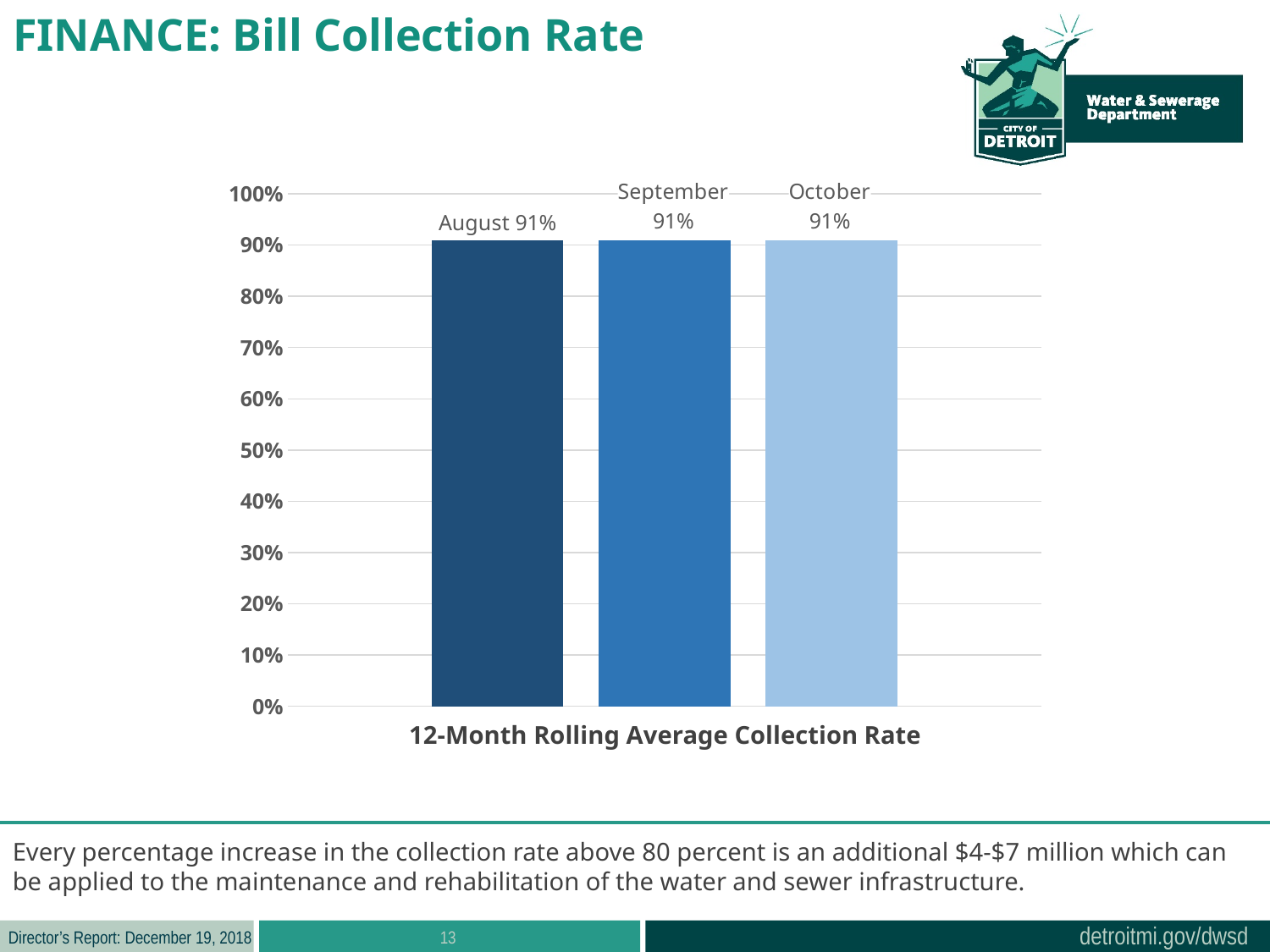
What is the difference between the October and August collection rates? 0% Is the value for October greater or less than 100%? less What is the highest value shown on the y axis? 100% What kind of chart is shown on the slide? bar chart What is the collection rate for September? 91% Do the collection rates rise, fall, or stay flat from August to October? stay flat What is the collection rate for October? 91% What is the label shown beneath the bars on the x axis? 12-Month Rolling Average Collection Rate What is the collection rate for August? 91% Is the value for September greater or less than 80%? greater How many months are shown as bars in the chart? 3